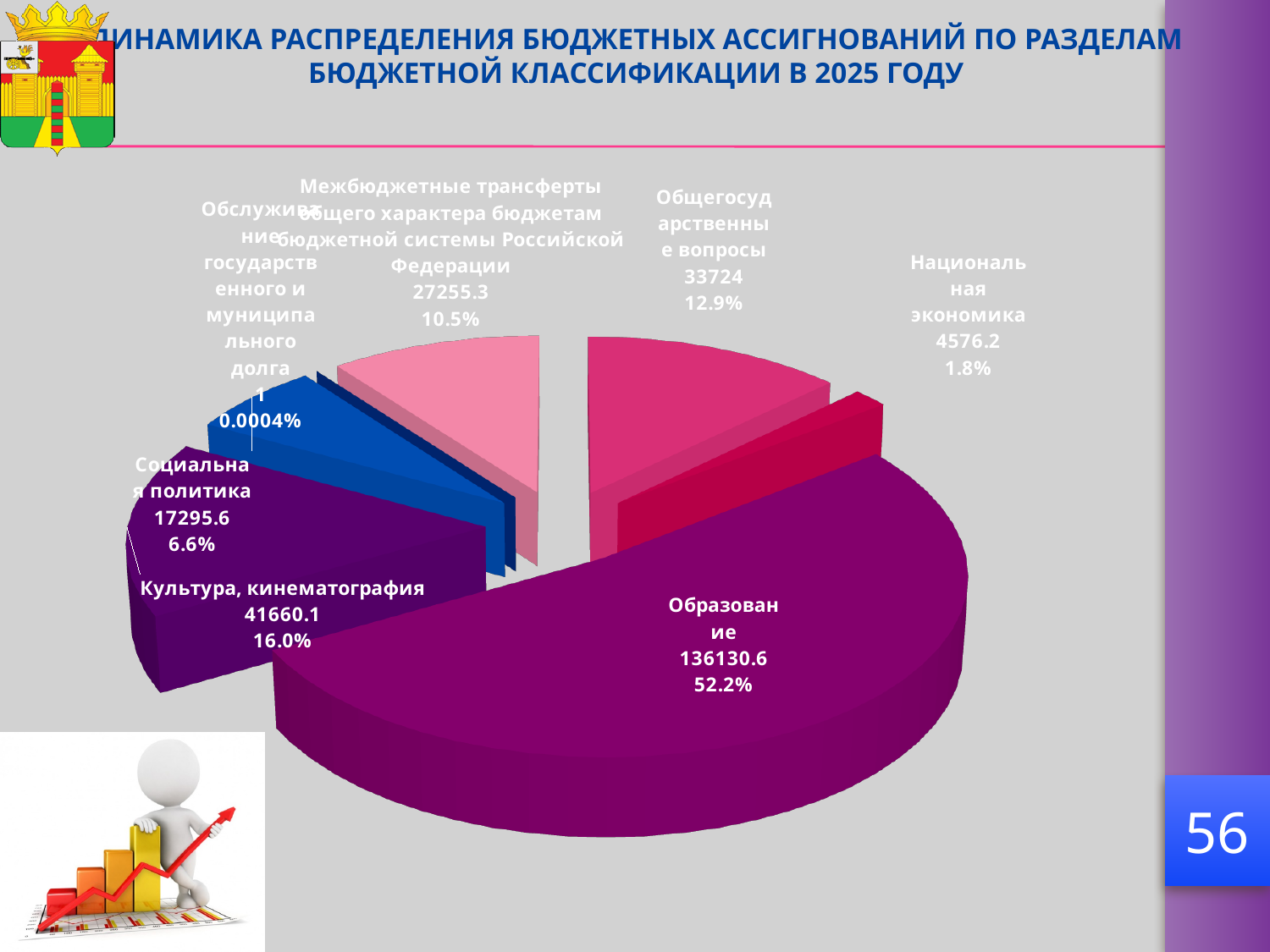
What share of the pie does Образование represent? 52.2% How many categories (slices) does the pie chart show? 7 What percentage is shown for Национальная экономика? 1.8% What value is shown for Культура, кинематография? 41660.1 What value is shown for Образование? 136130.6 Which is larger, the value for Культура, кинематография or the value for Общегосударственные вопросы? Культура, кинематография What percentage is shown for Общегосударственные вопросы? 12.9% What is the difference between the values for Общегосударственные вопросы and Межбюджетные трансферты общего характера бюджетам бюджетной системы Российской Федерации? 6468.7 What value is shown for Социальная политика? 17295.6 Which category has the smallest slice of the pie? Обслуживание государственного и муниципального долга Which category has the largest slice of the pie? Образование What type of chart is shown on the slide? pie chart